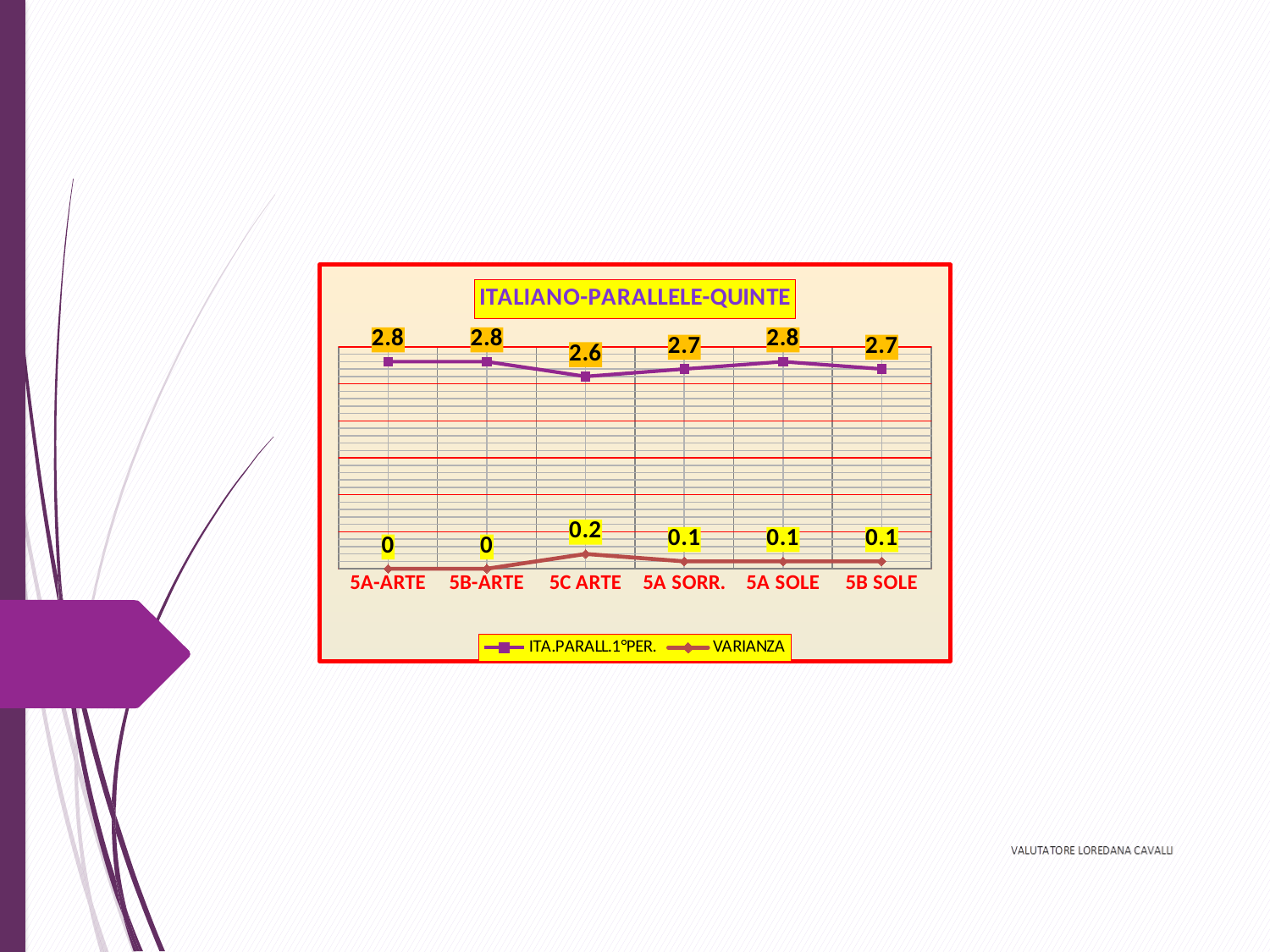
What is the VARIANZA value for 5A-ARTE? 0 Which category has the lowest ITA.PARALL.1°PER. value? 5C ARTE How many categories are shown on the x axis? 6 How many series does the legend list? 2 What is the VARIANZA value for 5C ARTE? 0.2 What is the difference between the ITA.PARALL.1°PER. values for 5A-ARTE and 5C ARTE? 0.2 Which is larger, the ITA.PARALL.1°PER. value for 5A SOLE or for 5B SOLE? 5A SOLE What is the title of the chart? ITALIANO-PARALLELE-QUINTE What is the ITA.PARALL.1°PER. value for 5C ARTE? 2.6 What is the ITA.PARALL.1°PER. value for 5A SORR.? 2.7 What kind of chart is shown? Line chart Which category has the highest VARIANZA value? 5C ARTE